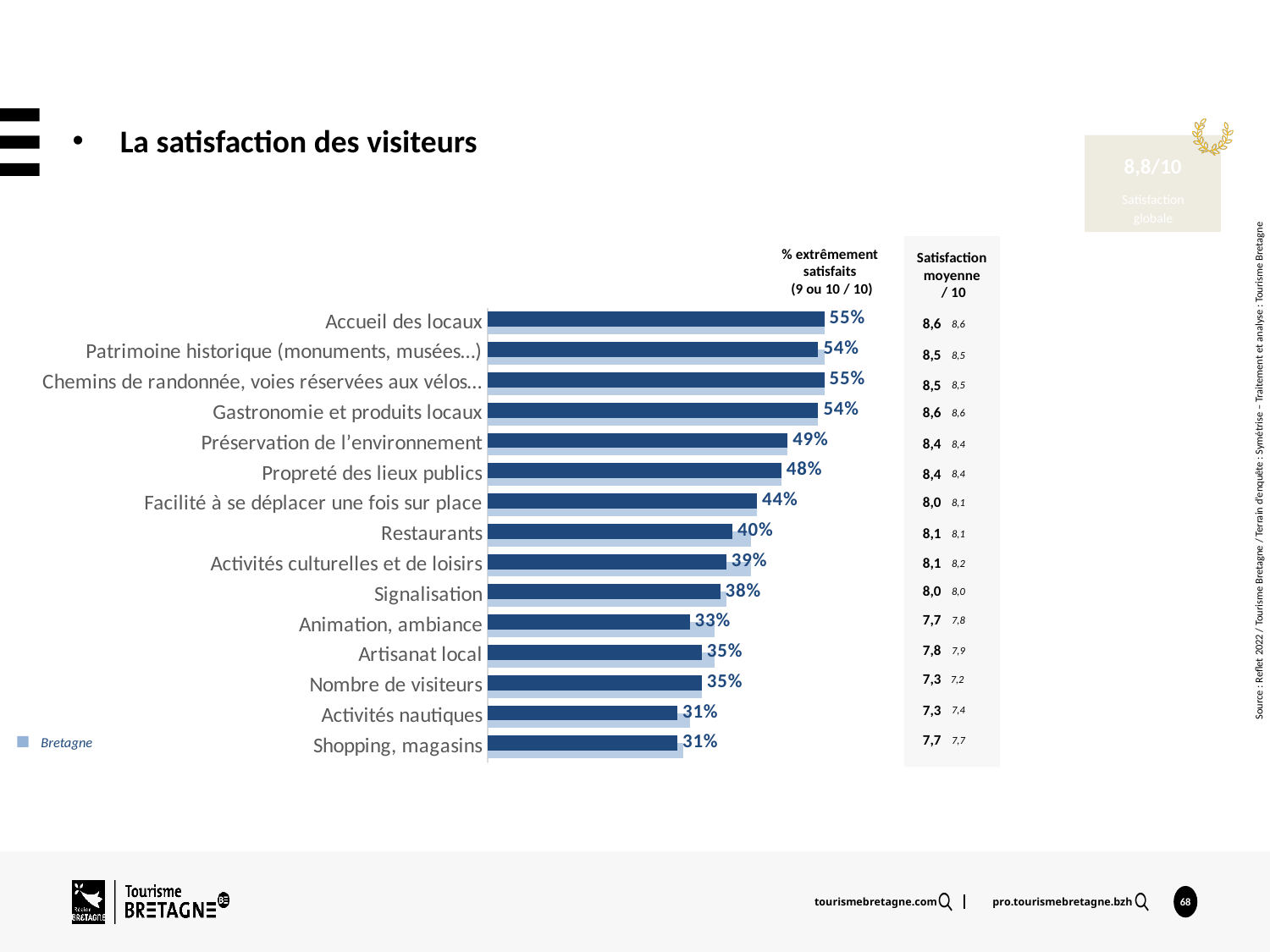
What is the value for Restaurants? 40% What is the value for Shopping, magasins? 31% What is the title of the slide? La satisfaction des visiteurs Which has a larger value, Activités nautiques or Facilité à se déplacer une fois sur place? Facilité à se déplacer une fois sur place How many categories are shown in the chart? 15 What is the difference between the values for Accueil des locaux and Shopping, magasins? 24% What is the value for Préservation de l'environnement? 49% Which has a larger value, Propreté des lieux publics or Animation, ambiance? Propreté des lieux publics What kind of chart is shown on the slide? Bar chart What is the value for Signalisation? 38% What is the value for Accueil des locaux? 55% What is the difference between the values for Gastronomie et produits locaux and Restaurants? 14%